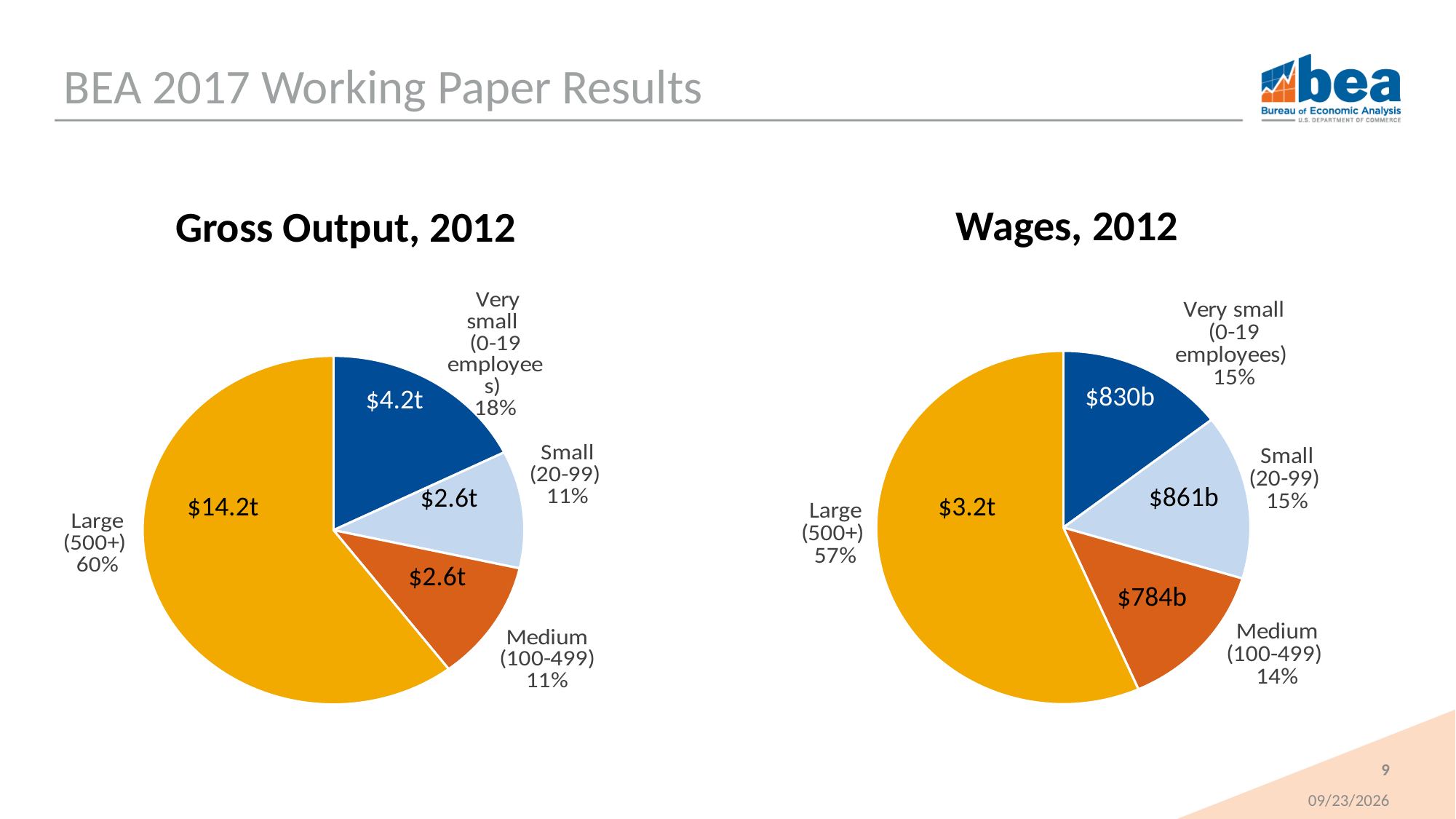
In the Gross Output, 2012 chart, which category has the largest slice? Large (500+) In the Wages, 2012 chart, what colour is the Large (500+) slice? Yellow/orange In the Wages, 2012 chart, what is the value for Very small (0-19 employees) firms? $830b In the Wages, 2012 chart, which category has the smallest slice? Medium (100-499) In the Wages, 2012 chart, what share of the pie does the Large (500+) slice represent? 57% What kind of chart is the Gross Output, 2012 chart? Pie chart How many categories are shown in the Wages, 2012 chart? 4 In the Wages, 2012 chart, what is the difference between the Small (20-99) value and the Medium (100-499) value? $77b In the Gross Output, 2012 chart, what share of the pie does the Very small (0-19 employees) slice represent? 18% In the Gross Output, 2012 chart, which is larger: the Very small (0-19 employees) slice or the Small (20-99) slice? Very small (0-19 employees) In the Gross Output, 2012 chart, what is the value for Large (500+) firms? $14.2t In the Wages, 2012 chart, what is the value for Medium (100-499) firms? $784b